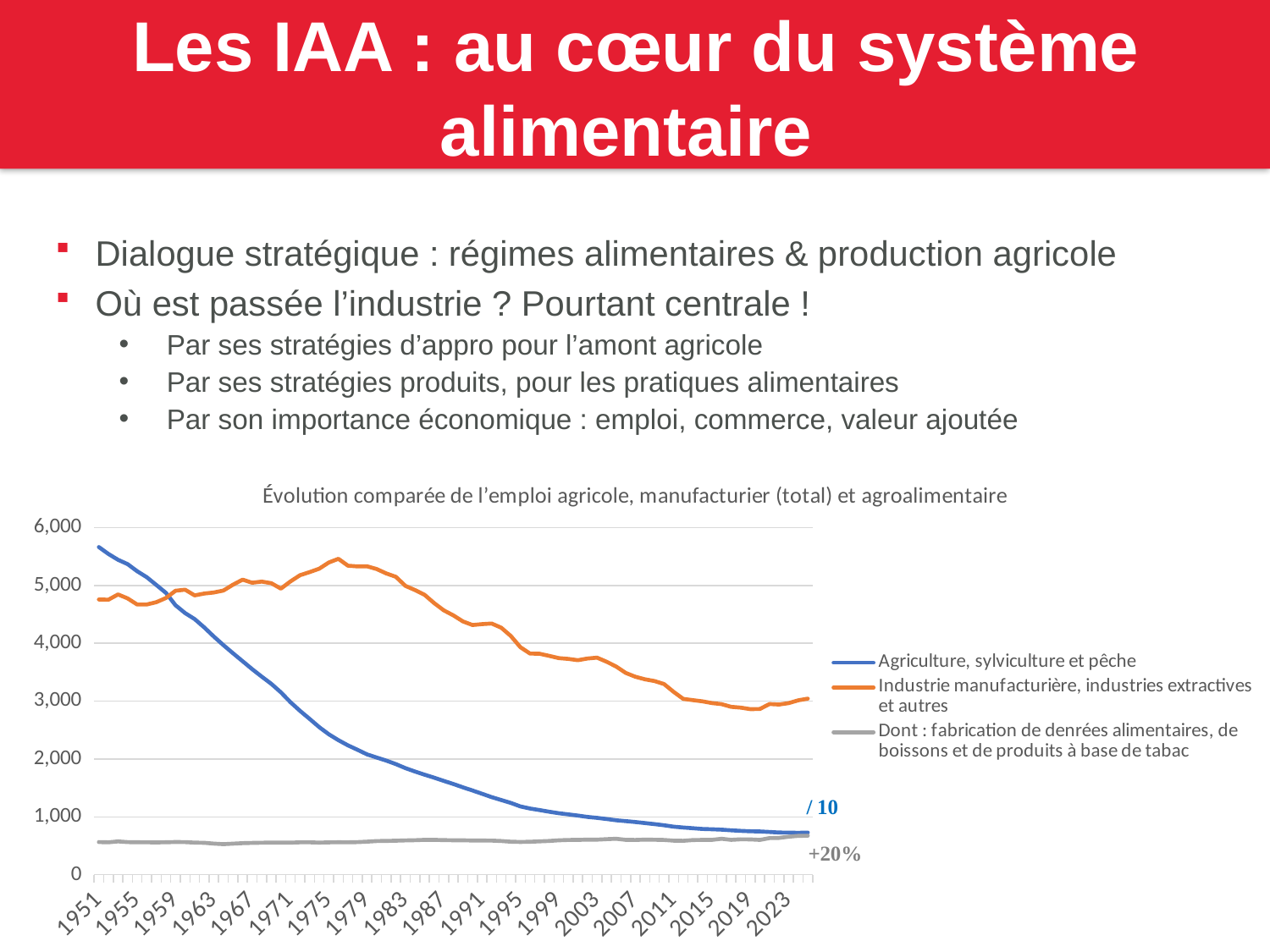
Is the value for Agriculture, sylviculture et pêche in 1951 greater or less than 5,000? greater How many series does the chart's legend list? 3 What is the title of the chart? Évolution comparée de l'emploi agricole, manufacturier (total) et agroalimentaire In 1951, which is larger: Agriculture, sylviculture et pêche or Industrie manufacturière, industries extractives et autres? Agriculture, sylviculture et pêche Which series has the lowest value in 1951? Dont : fabrication de denrées alimentaires, de boissons et de produits à base de tabac Is the value for Agriculture, sylviculture et pêche in 2023 greater or less than 1,000? less Which series has the highest value in 2023? Industrie manufacturière, industries extractives et autres Is the value for Industrie manufacturière, industries extractives et autres in 1951 greater or less than 5,000? less What kind of chart is shown on the slide? line chart Which series is drawn in orange? Industrie manufacturière, industries extractives et autres Does the value for Agriculture, sylviculture et pêche rise or fall from 1951 to 2023? fall